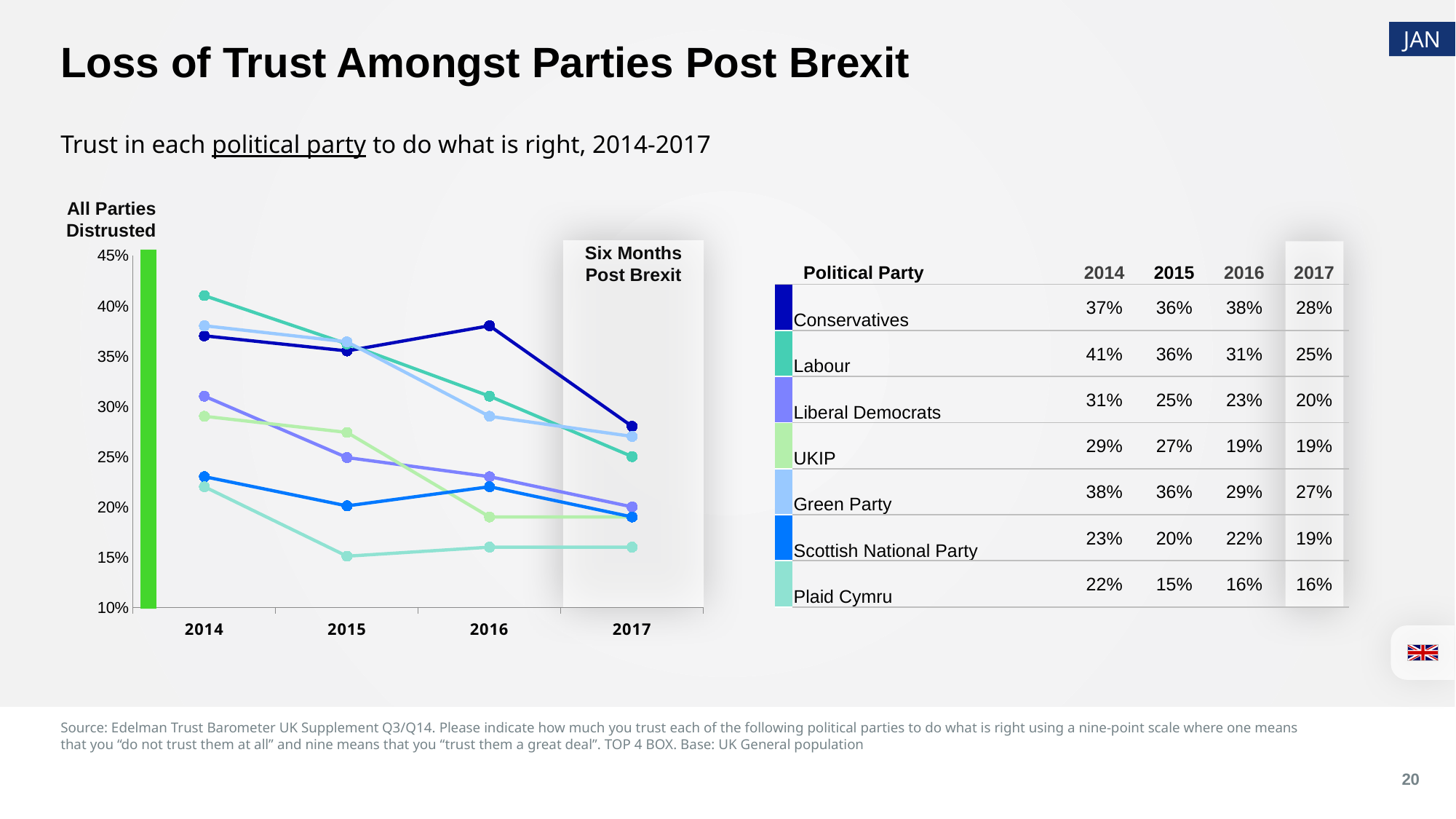
Which had higher trust in 2016, the Conservatives or Labour? Conservatives Which political party had the highest trust in 2014? Labour How many years are shown on the x axis of the chart? 4 What is the difference between trust in the Conservatives in 2016 and in 2017? 10% What was trust in the Green Party in 2016? 29% What kind of chart is shown on the slide? line chart What label is shown on the shaded area covering 2017 on the chart? Six Months Post Brexit What was trust in the Conservatives in 2017? 28% Which political party had the lowest trust in 2015? Plaid Cymru How many political parties are plotted on the chart? 7 What was trust in Labour in 2014? 41% Does trust in Labour rise or fall from 2014 to 2017? fall